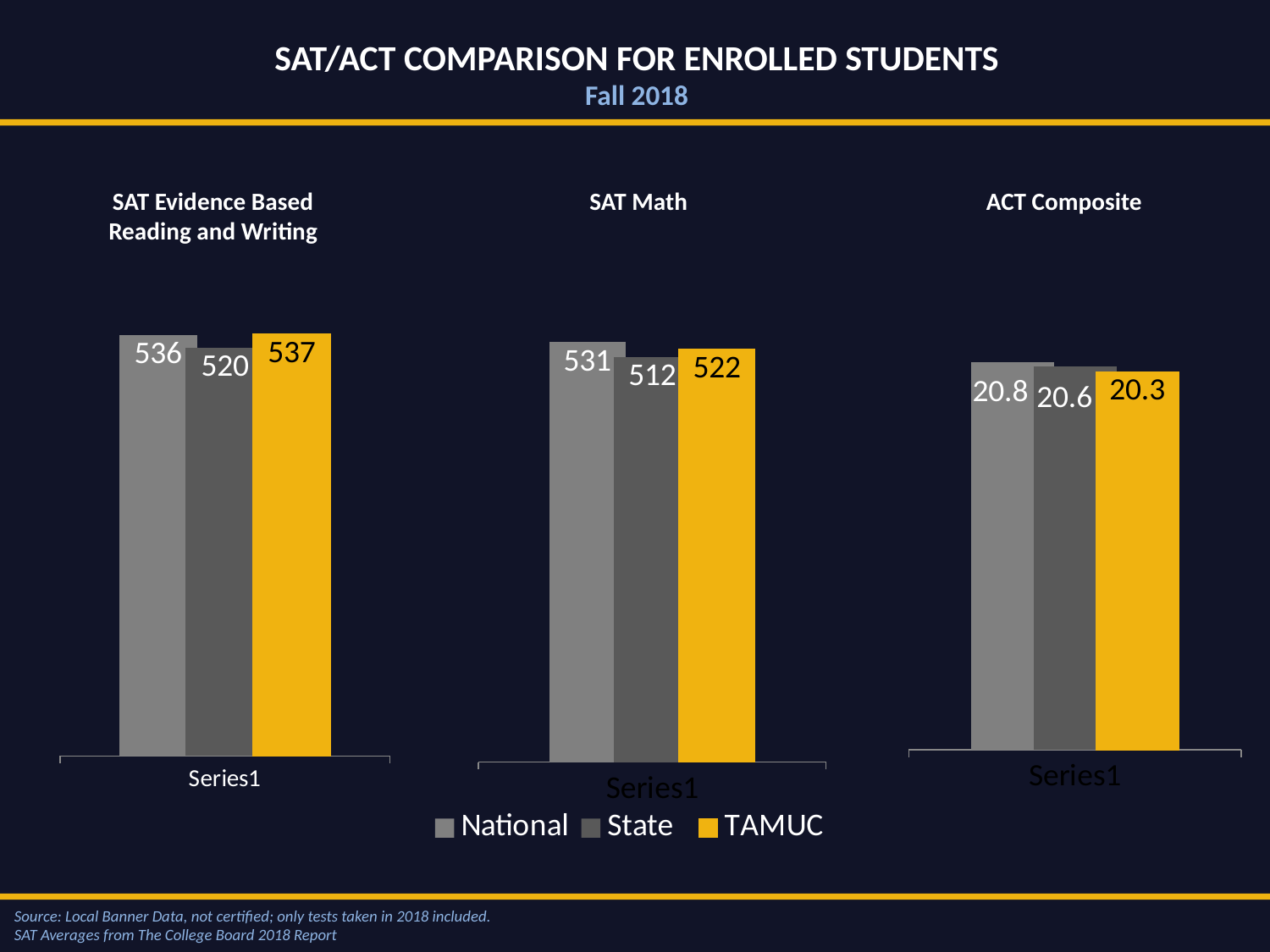
In the SAT Math chart, which series has the highest value? National In the SAT Evidence Based Reading and Writing chart, what is the value for TAMUC? 537 In the ACT Composite chart, what is the difference between the National and TAMUC values? 0.5 In the SAT Math chart, which is larger, the TAMUC value or the State value? TAMUC How many series does the legend list? 3 In the ACT Composite chart, what is the value for National? 20.8 In the SAT Math chart, what is the difference between the National and State values? 19 What kind of chart is the SAT Math chart? bar chart In the SAT Math chart, what is the value for State? 512 In the SAT Evidence Based Reading and Writing chart, which is larger, the National value or the State value? National In the SAT Evidence Based Reading and Writing chart, which series has the lowest value? State Which series is shown in yellow in the charts? TAMUC